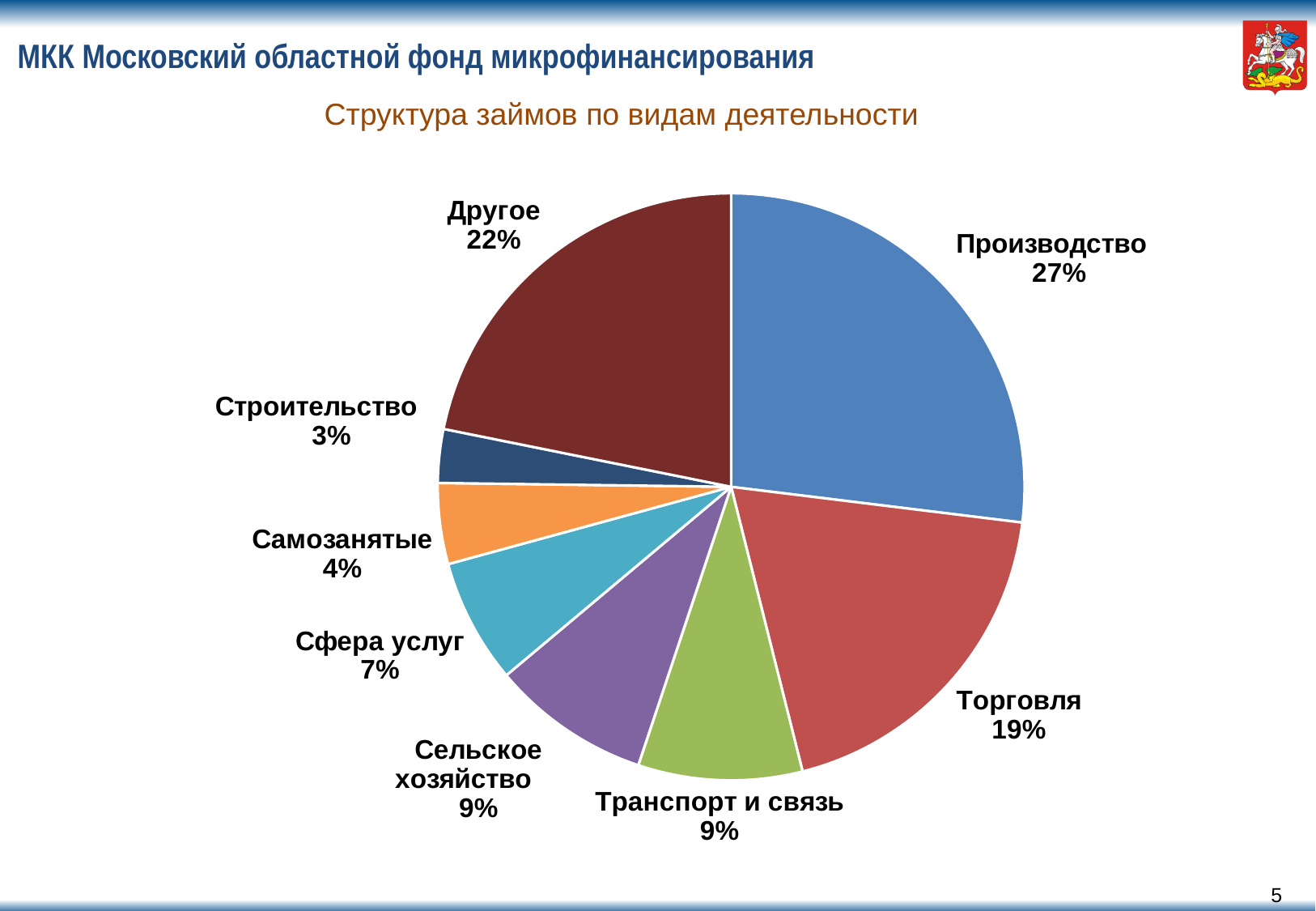
What is the value for Сфера услуг? 7% How many categories are shown in the pie chart? 8 Which category has the largest share of the pie? Производство What is the title of the chart? Структура займов по видам деятельности What is the difference in percentage points between Другое and Строительство? 19 What type of chart is shown on the slide? Pie chart What share of loans goes to Производство? 27% What percentage is shown for Торговля? 19% Which category has the smallest share of the pie? Строительство What share is labelled for Самозанятые? 4% Which is larger, Другое or Торговля? Другое What is the difference in percentage points between Производство and Торговля? 8